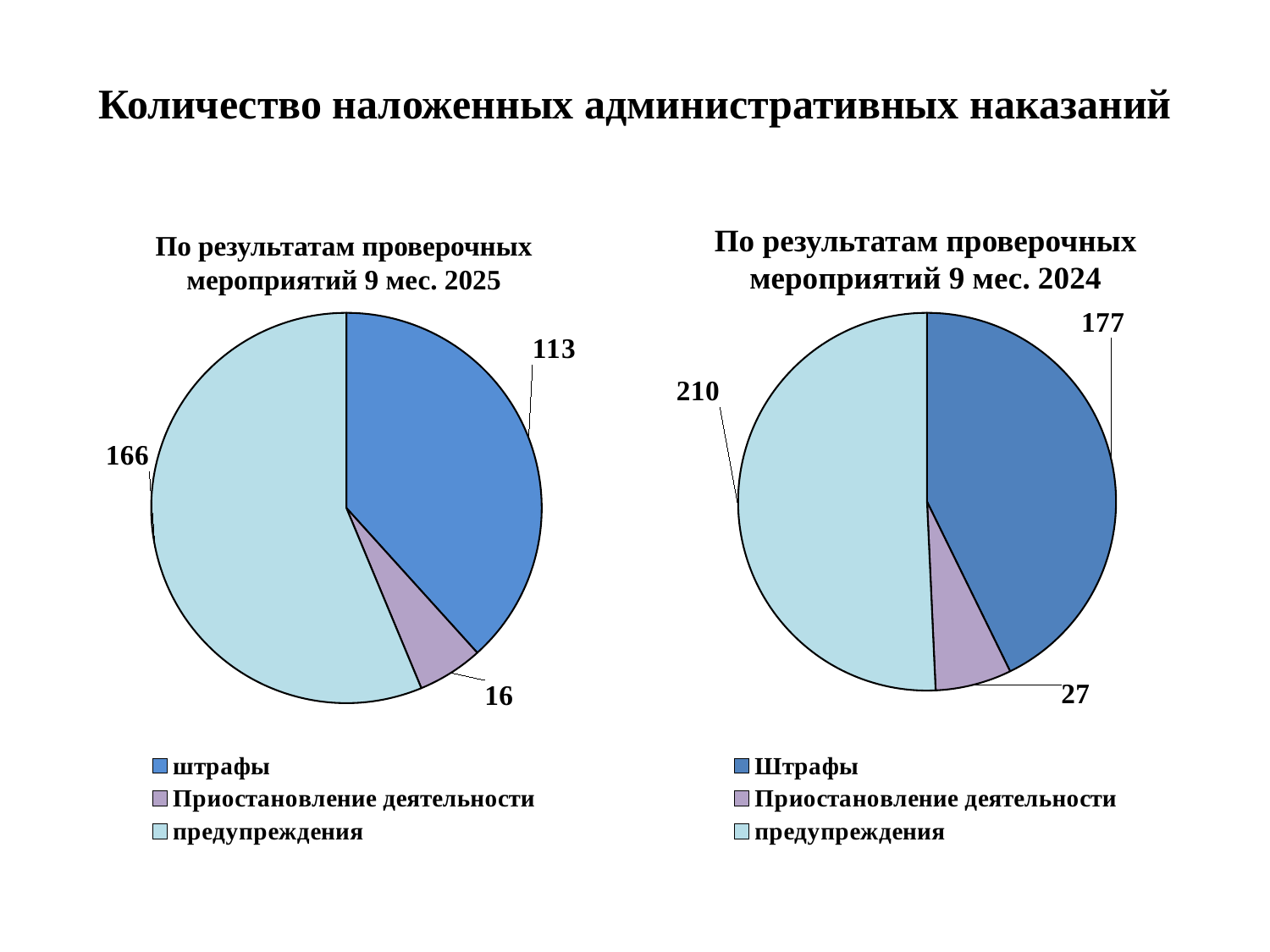
In the left chart (9 мес. 2025), which category has the smallest slice? Приостановление деятельности In the right chart (9 мес. 2024), what is the value for предупреждения? 210 How many slices does the left chart (9 мес. 2025) have? 3 In the left chart (9 мес. 2025), what share of the total do предупреждения represent? 56.3% In the left chart (9 мес. 2025), what is the value for штрафы? 113 In the right chart (9 мес. 2024), which category has the largest slice? предупреждения What is the total of all slices in the right chart (9 мес. 2024)? 414 What type of chart is used on this slide? Pie chart How many entries does the legend of the right chart (9 мес. 2024) list? 3 Which is larger: штрафы in the left chart (2025) or Штрафы in the right chart (2024)? Штрафы in the right chart (2024), 177 In the left chart (9 мес. 2025), what is the value for Приостановление деятельности? 16 In the right chart (9 мес. 2024), what is the difference between Штрафы and Приостановление деятельности? 150